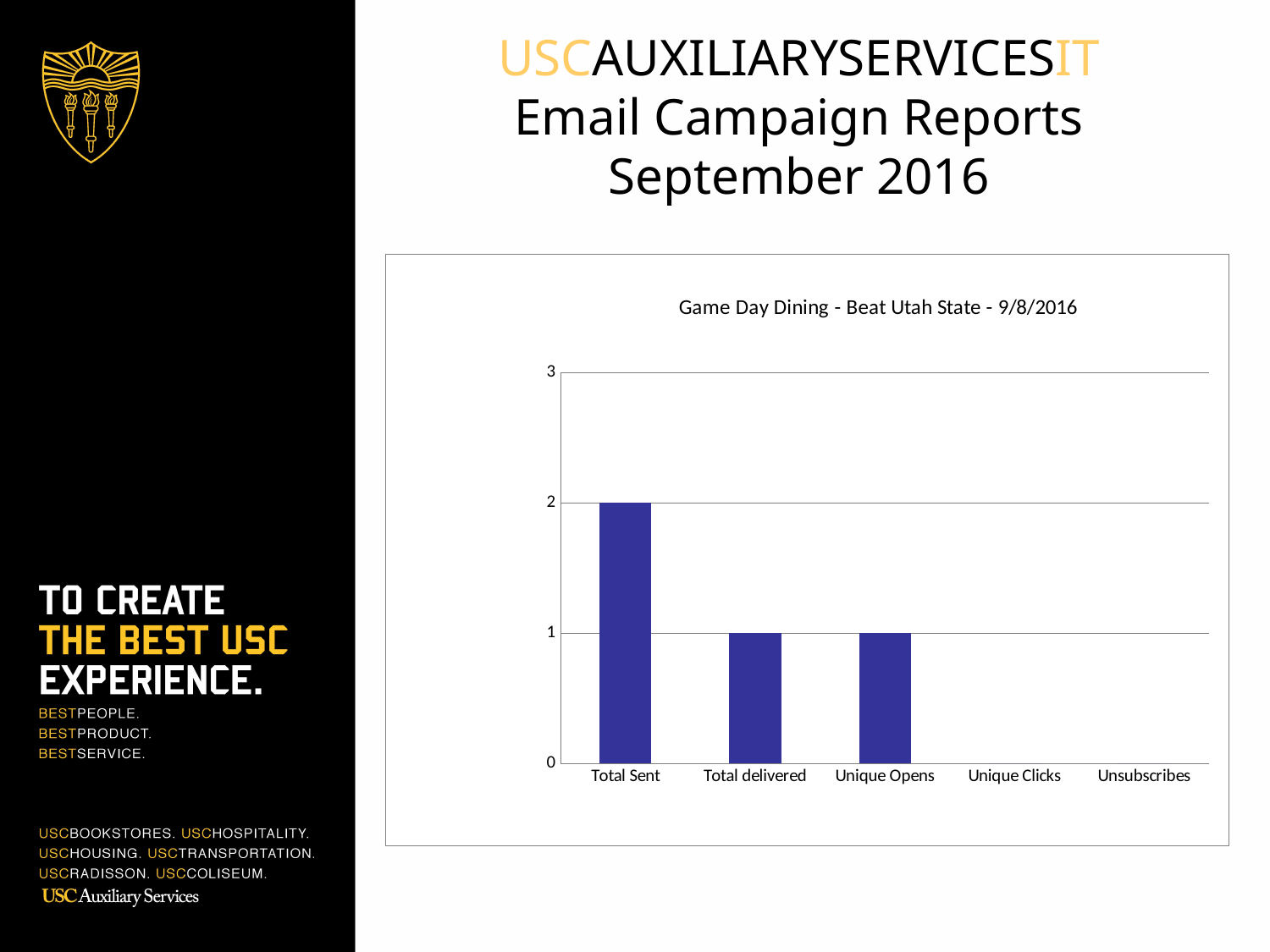
What is the value for Unique Clicks? 0 What kind of chart is shown on the slide? bar chart Which category has the highest value? Total Sent Is the value for Total Sent greater or less than 1? greater What is the difference between Total Sent and Total delivered? 1 What is the highest value shown on the y axis? 3 Which is larger, Total Sent or Unique Opens? Total Sent What is the title of the chart? Game Day Dining - Beat Utah State - 9/8/2016 What is the value for Unique Opens? 1 How many categories are shown on the x axis of the chart? 5 What is the value for Total Sent? 2 What is the value for Total delivered? 1